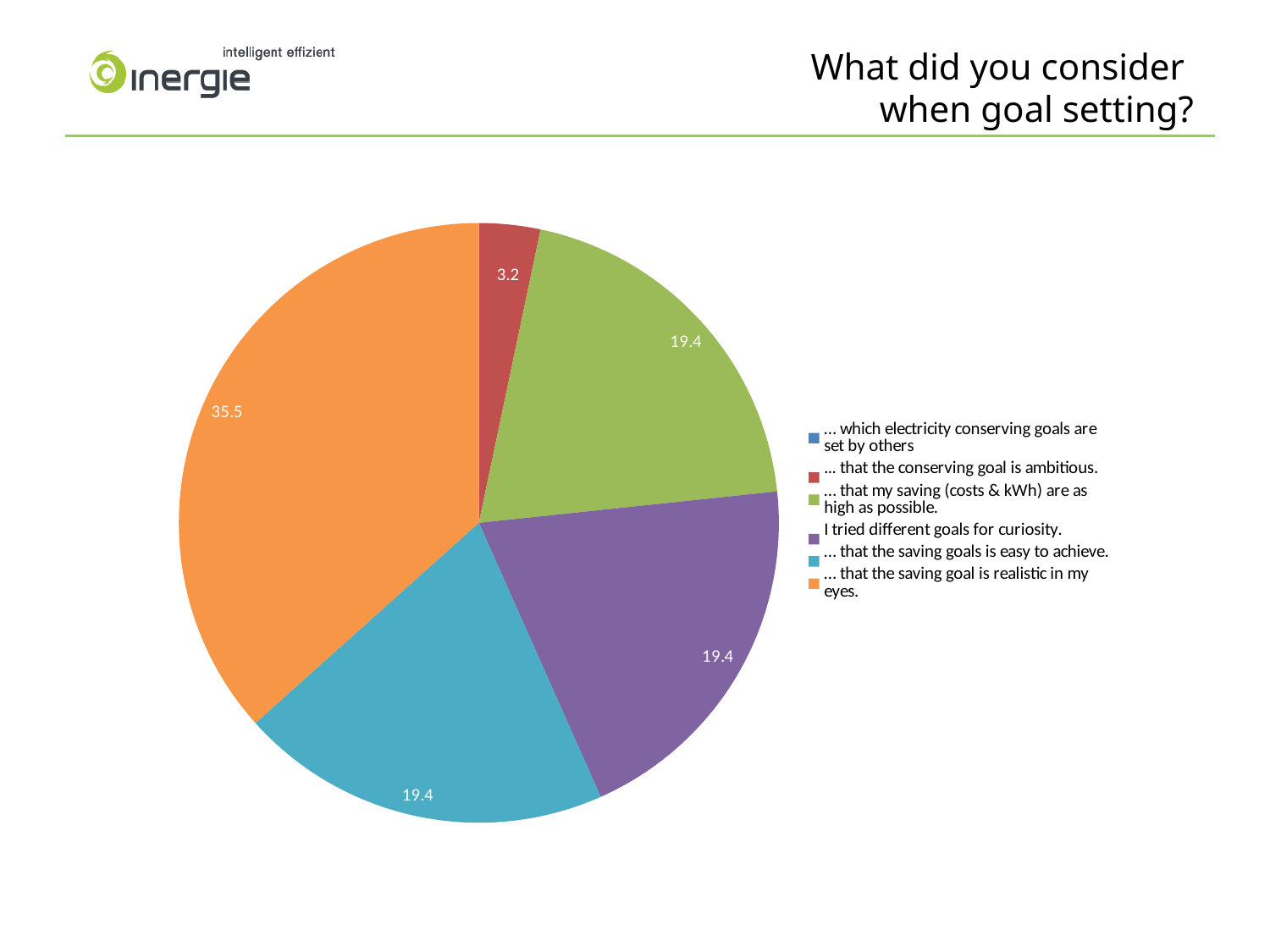
What is the value of the slice for "... that my saving (costs & kWh) are as high as possible."? 19.4 What is the value of the slice for "... that the saving goals is easy to achieve."? 19.4 What kind of chart is shown on the slide? pie chart How many entries does the legend list? 6 What is the title of the slide containing the chart? What did you consider when goal setting? Which category has the largest slice of the pie? ... that the saving goal is realistic in my eyes. What is the difference between the value for "... that the saving goal is realistic in my eyes." and the value for "... that the conserving goal is ambitious."? 32.3 What is the value of the slice for "I tried different goals for curiosity."? 19.4 Which is larger: the slice for "... that the saving goal is realistic in my eyes." or the slice for "... that the saving goals is easy to achieve."? ... that the saving goal is realistic in my eyes. What is the value of the slice for "... that the conserving goal is ambitious."? 3.2 What is the value of the slice for "... that the saving goal is realistic in my eyes."? 35.5 Which labelled slice of the pie is the smallest? ... that the conserving goal is ambitious.